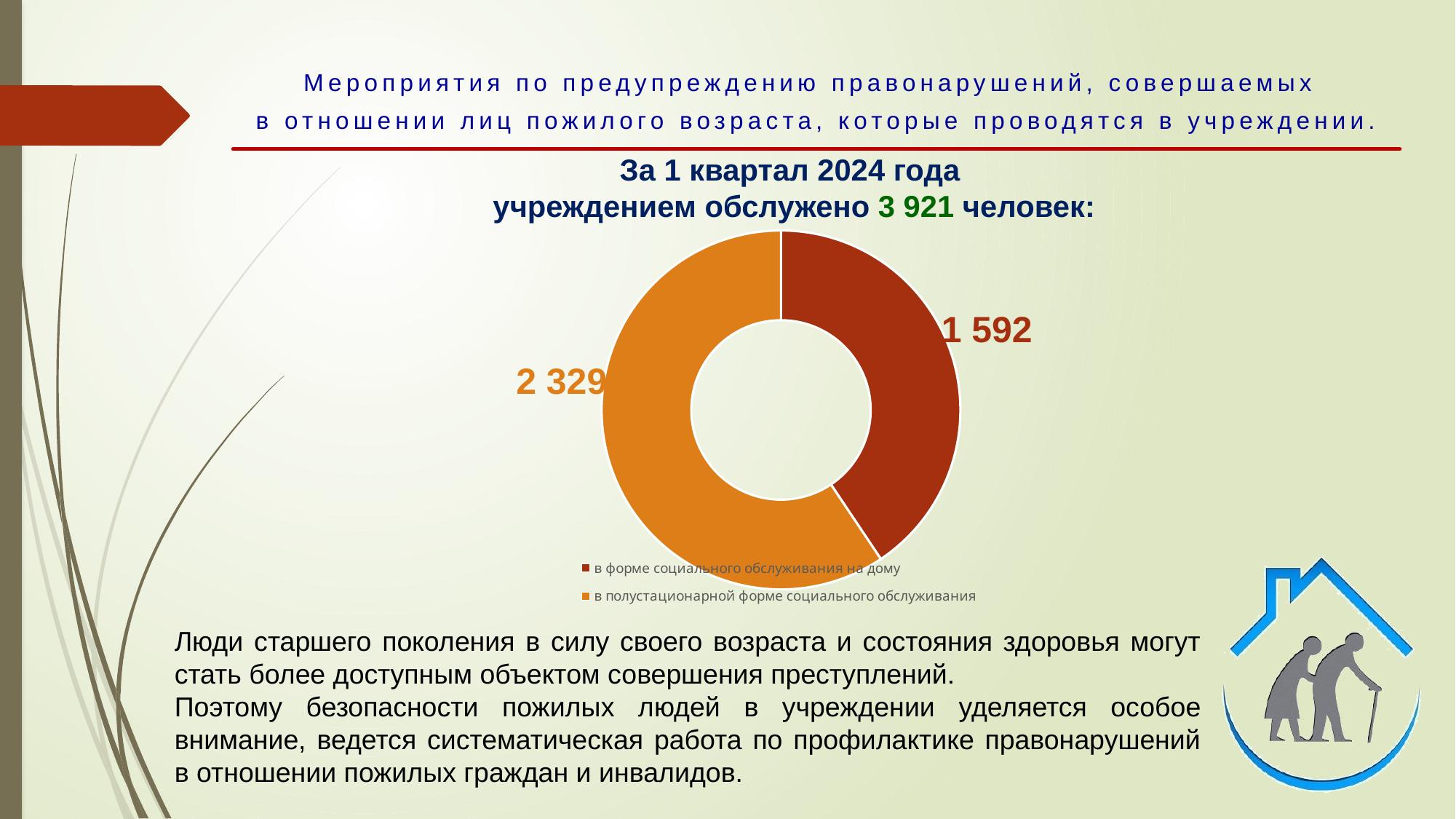
What is the difference between the value for "в полустационарной форме социального обслуживания" and the value for "в форме социального обслуживания на дому"? 737 What is the value for "в полустационарной форме социального обслуживания"? 2 329 What colour is the slice for "в форме социального обслуживания на дому"? Dark red What is the value for "в форме социального обслуживания на дому"? 1 592 How many slices does the chart have? 2 What share of the total does "в полустационарной форме социального обслуживания" represent? 59.4% Which is larger: the value for "в форме социального обслуживания на дому" or the value for "в полустационарной форме социального обслуживания"? в полустационарной форме социального обслуживания Which category has the largest slice of the chart? в полустационарной форме социального обслуживания What kind of chart is shown on the slide? Pie (doughnut) chart How many entries does the chart legend list? 2 Which category has the smallest slice of the chart? в форме социального обслуживания на дому What is the total number of people served according to the chart heading? 3 921